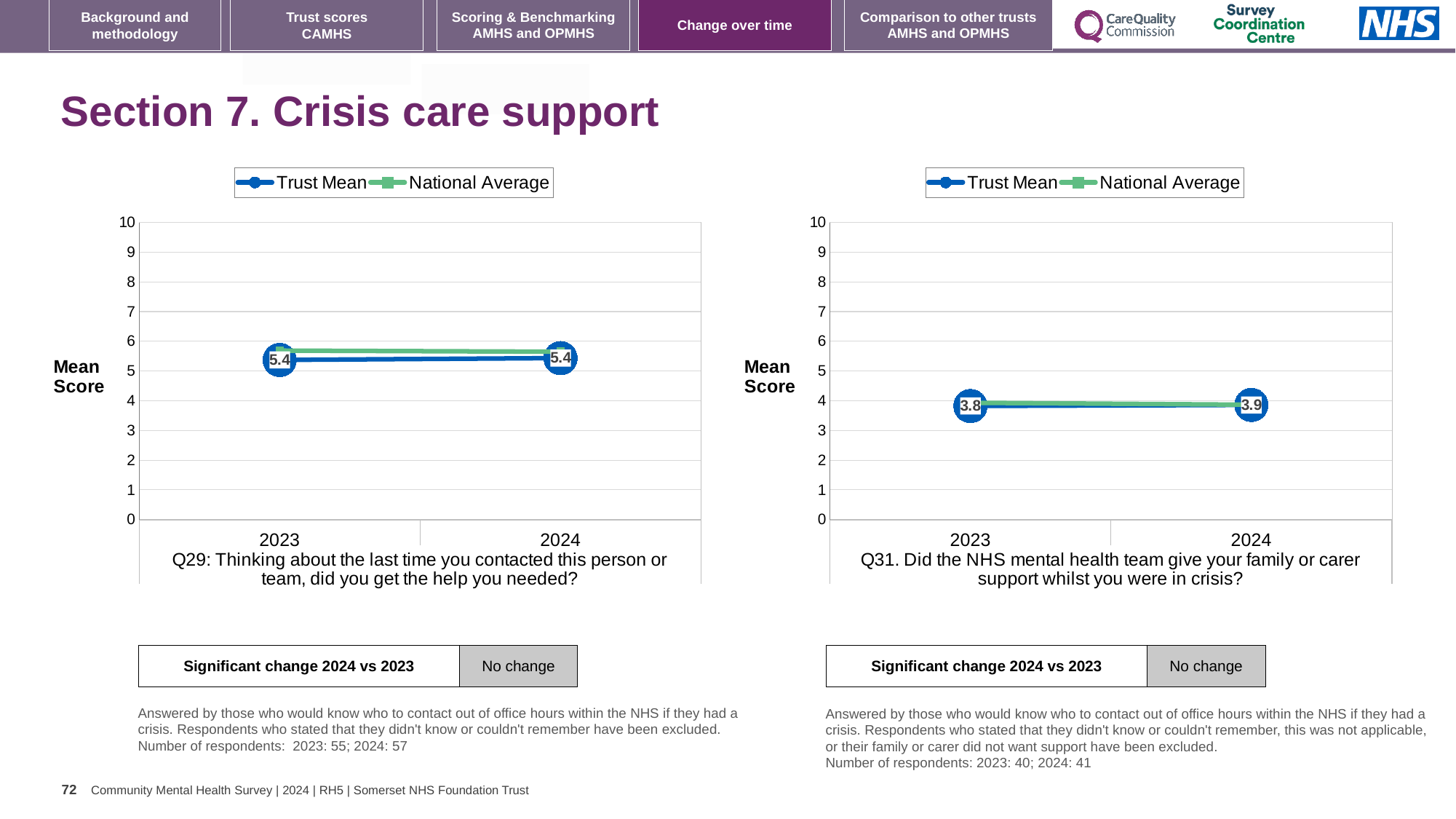
What kind of chart is the right chart (Q31)? Line chart In the left chart (Q29), what is the Trust Mean score for 2024? 5.4 In the left chart (Q29), does the Trust Mean rise, fall or stay the same from 2023 to 2024? Stays the same In the left chart (Q29), is the National Average value for 2024 greater or less than 5? greater In the right chart (Q31), which year has the higher Trust Mean score, 2023 or 2024? 2024 In the right chart (Q31), what is the difference between the Trust Mean scores for 2024 and 2023? 0.1 In the right chart (Q31), is the National Average value for 2023 greater or less than 3? greater How many series does the legend of the left chart (Q29) list? 2 In the left chart (Q29), what is the Trust Mean score for 2023? 5.4 In the right chart (Q31), what is the Trust Mean score for 2024? 3.9 In the right chart (Q31), does the Trust Mean rise or fall from 2023 to 2024? Rise In the right chart (Q31), what is the Trust Mean score for 2023? 3.8